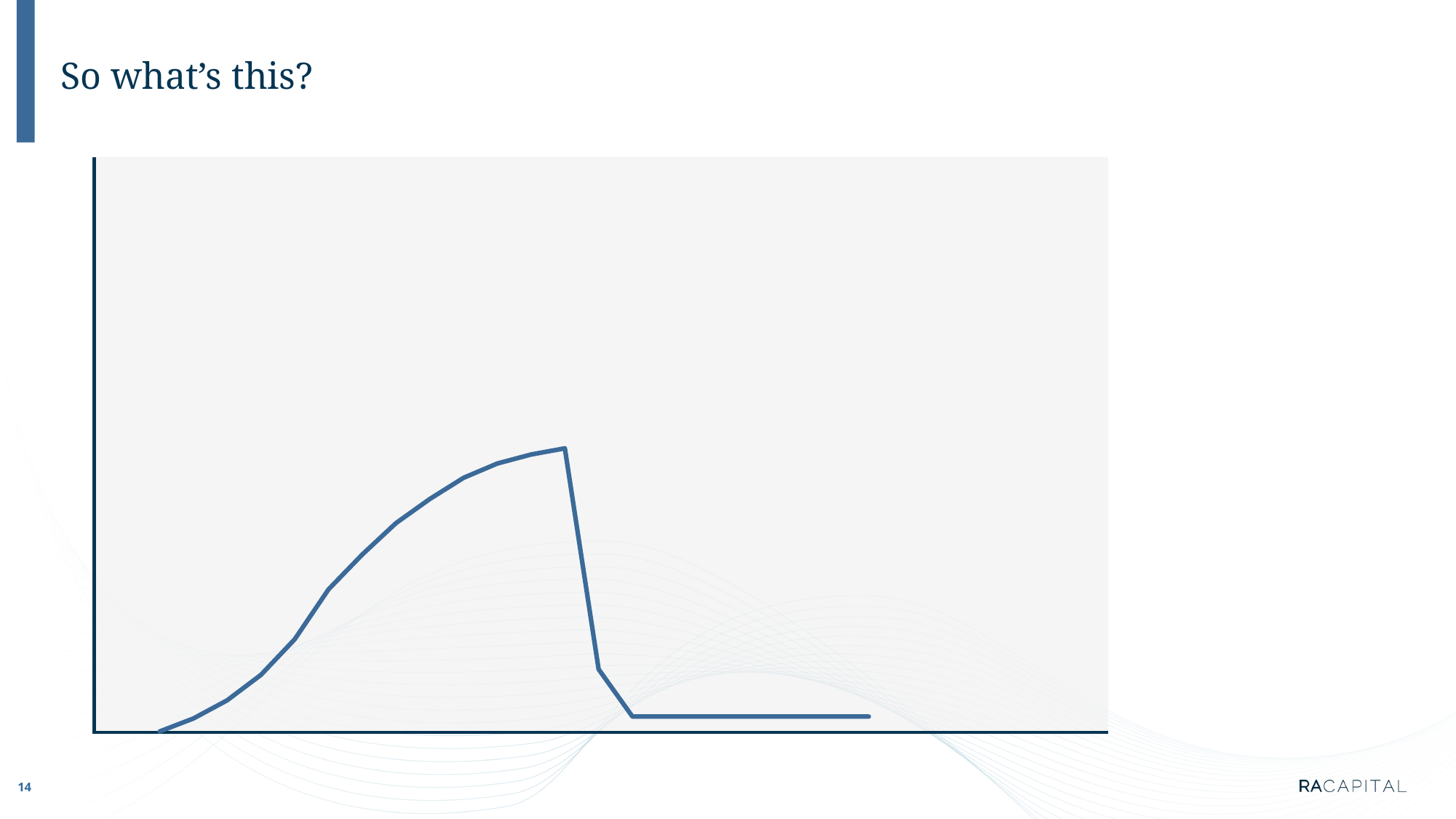
Does the chart display any axis labels or tick values? No What colour is the plotted line? Blue After reaching its peak, does the plotted line rise or fall? Fall How many lines are plotted on the chart? 1 What does the line do at the right end of the chart after its sharp drop? Stays flat Does the plotted line rise or fall over the left portion of the chart, before its peak? Rise What kind of chart is shown on the slide? Line chart